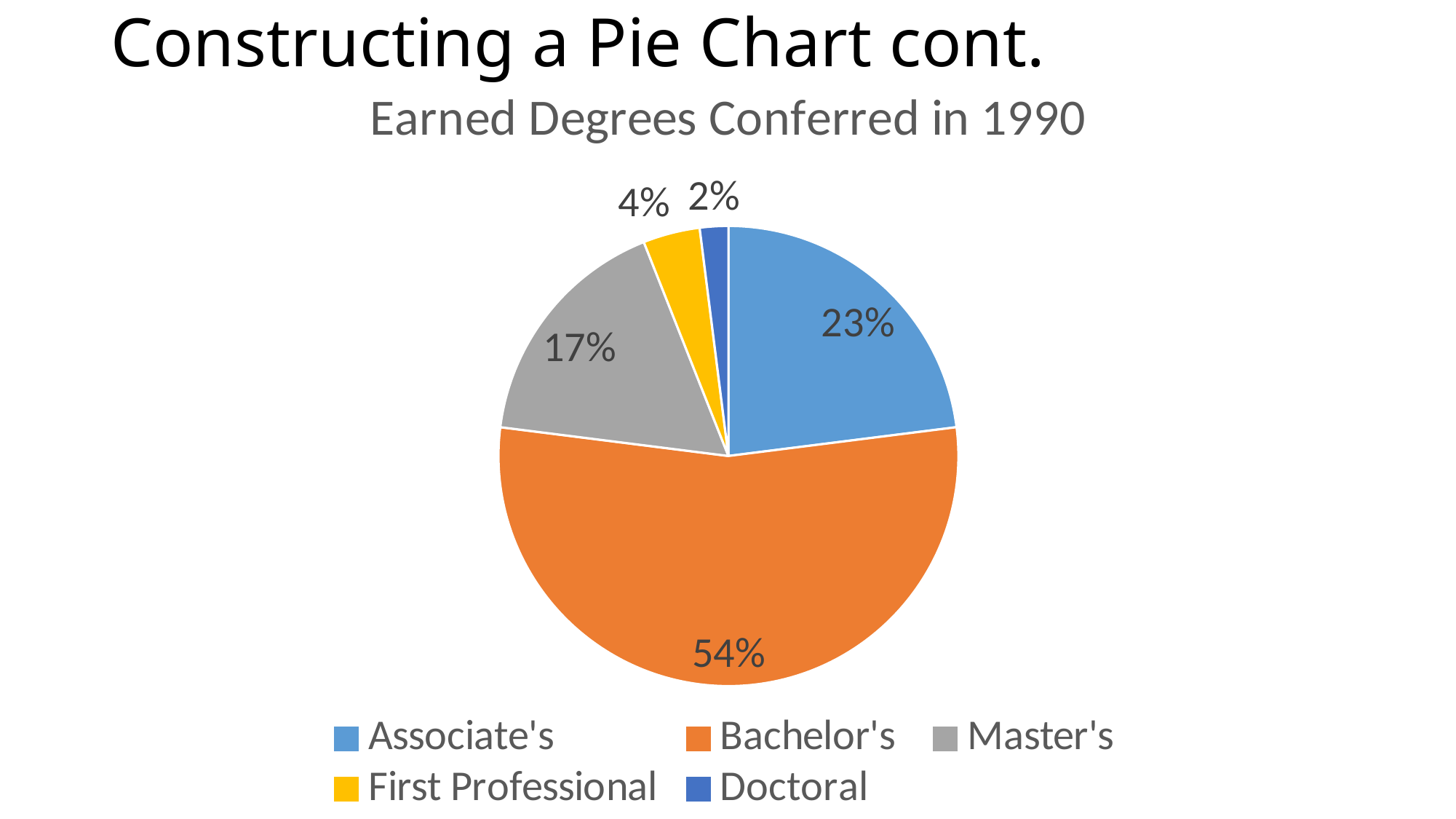
What share of the pie is First Professional? 4% What is the title of the chart? Earned Degrees Conferred in 1990 Which is larger, Master's or First Professional? Master's How many categories does the pie chart show? 5 What share of the pie is Master's? 17% Which degree category has the largest slice? Bachelor's What share of the pie is Doctoral? 2% What is the difference in percentage points between Bachelor's and Associate's? 31 Which degree category has the smallest slice? Doctoral What kind of chart is shown on the slide? pie chart